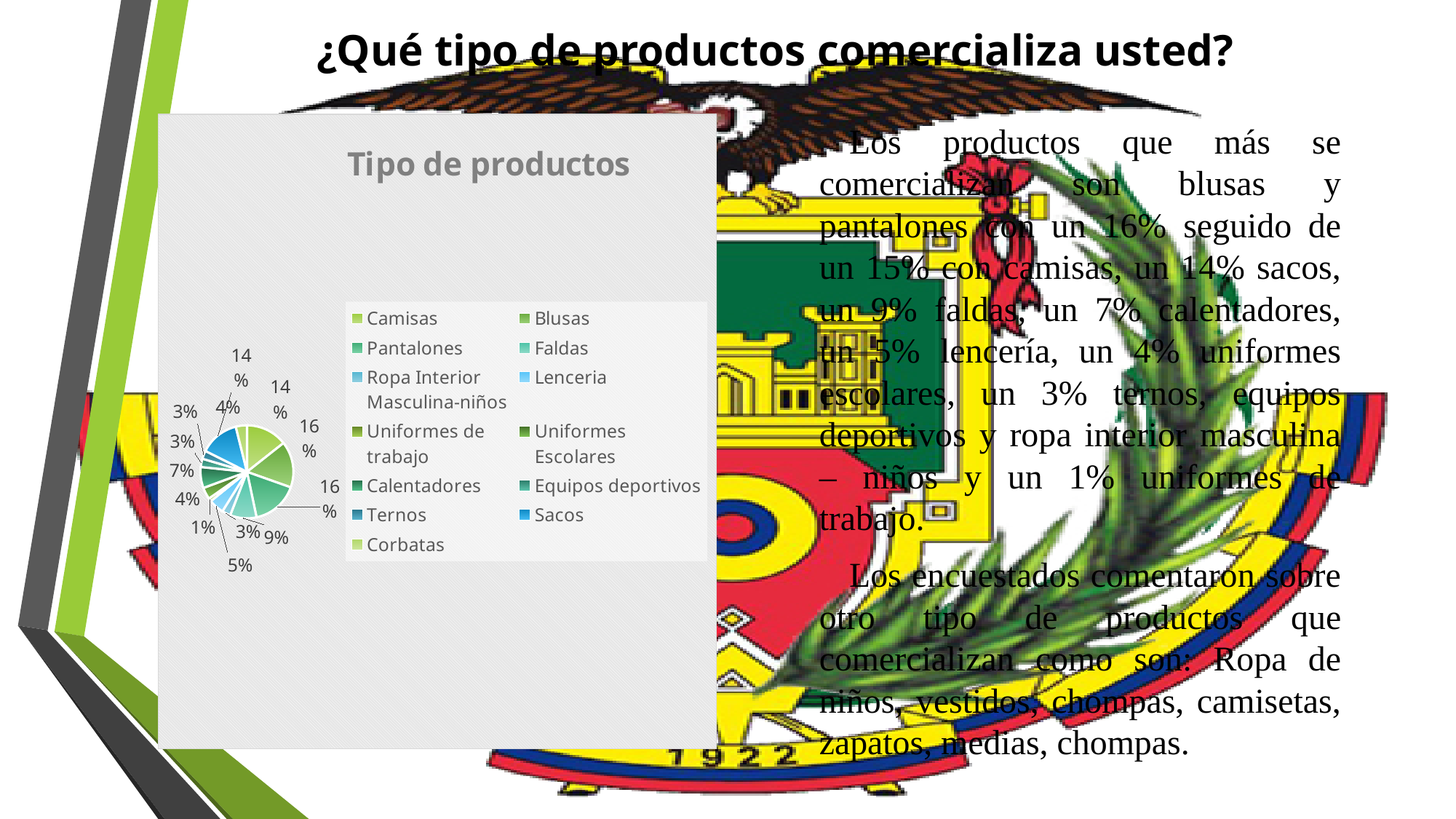
How many slices (data labels) does the pie chart show? 13 What is the largest percentage shown as a data label on the pie chart? 16% Is the smallest slice of the pie chart greater or less than 5%? less Is the largest slice of the pie chart greater or less than 10%? greater What is the smallest percentage shown as a data label on the pie chart? 1% How many slices of the pie chart are labelled 16%? 2 What type of chart is shown on the slide? pie chart What is the first entry listed in the pie chart's legend? Camisas What is the title of the chart on the slide? Tipo de productos How many entries does the legend of the pie chart list? 13